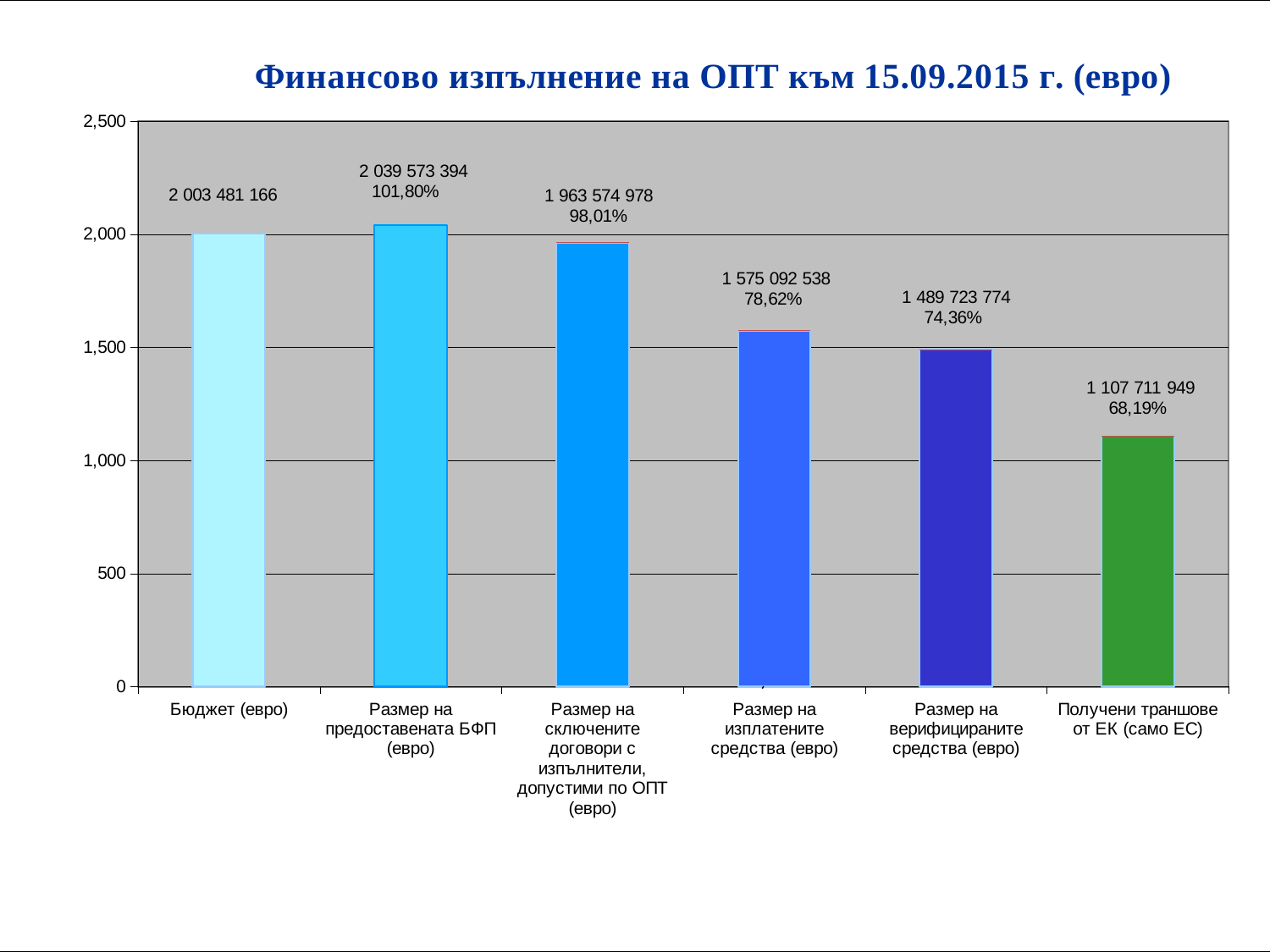
Which category has the highest value? Размер на предоставената БФП (евро) Which is larger: "Размер на сключените договори с изпълнители, допустими по ОПТ (евро)" or "Размер на верифицираните средства (евро)"? Размер на сключените договори с изпълнители, допустими по ОПТ (евро) What percentage is shown for "Размер на изплатените средства (евро)"? 78,62% What is the title of the chart? Финансово изпълнение на ОПТ към 15.09.2015 г. (евро) What is the value for "Размер на предоставената БФП (евро)"? 2 039 573 394 Which category has the lowest value? Получени траншове от ЕК (само ЕС) Is the value for "Получени траншове от ЕК (само ЕС)" greater or less than 1,500 on the axis? less How many categories are plotted in the chart? 6 What is the value for "Бюджет (евро)"? 2 003 481 166 What percentage is shown for "Получени траншове от ЕК (само ЕС)"? 68,19% What is the difference between "Размер на изплатените средства (евро)" and "Размер на верифицираните средства (евро)"? 85 368 764 What type of chart is shown on the slide? bar chart